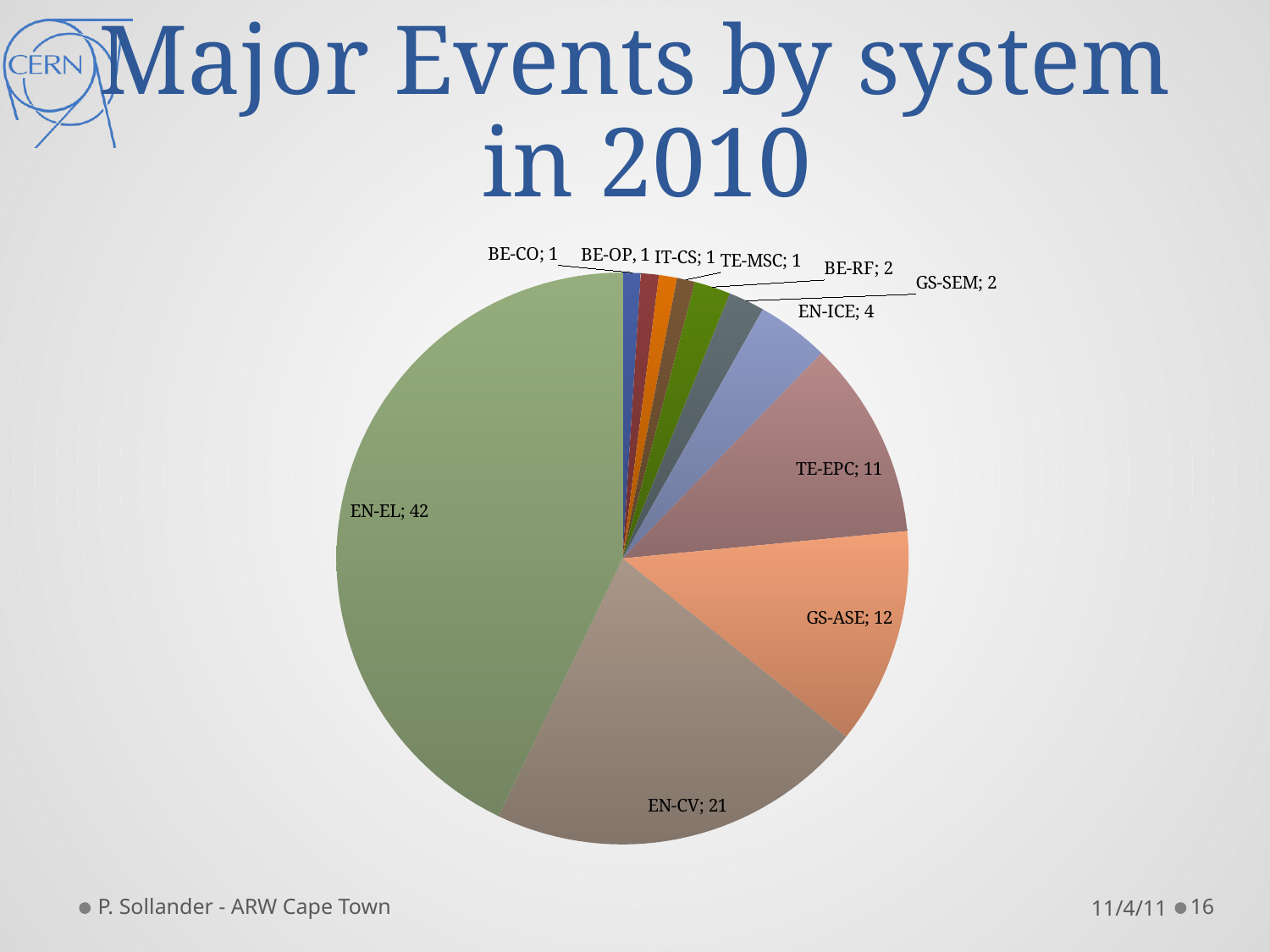
What is the title of the chart on the slide? Major Events by system in 2010 How many major events are attributed to EN-EL in the pie chart? 42 What is the value shown for TE-EPC? 11 What is the value shown for EN-ICE? 4 What is the difference between the values for EN-ICE and GS-SEM? 2 Which system has the largest slice of the pie? EN-EL What is the value shown for GS-ASE? 12 What kind of chart is shown on the slide? pie chart What is the value shown for EN-CV? 21 Which has a larger value, GS-ASE or TE-EPC? GS-ASE How many slices does the pie chart have? 11 What is the difference between the values for EN-EL and EN-CV? 21